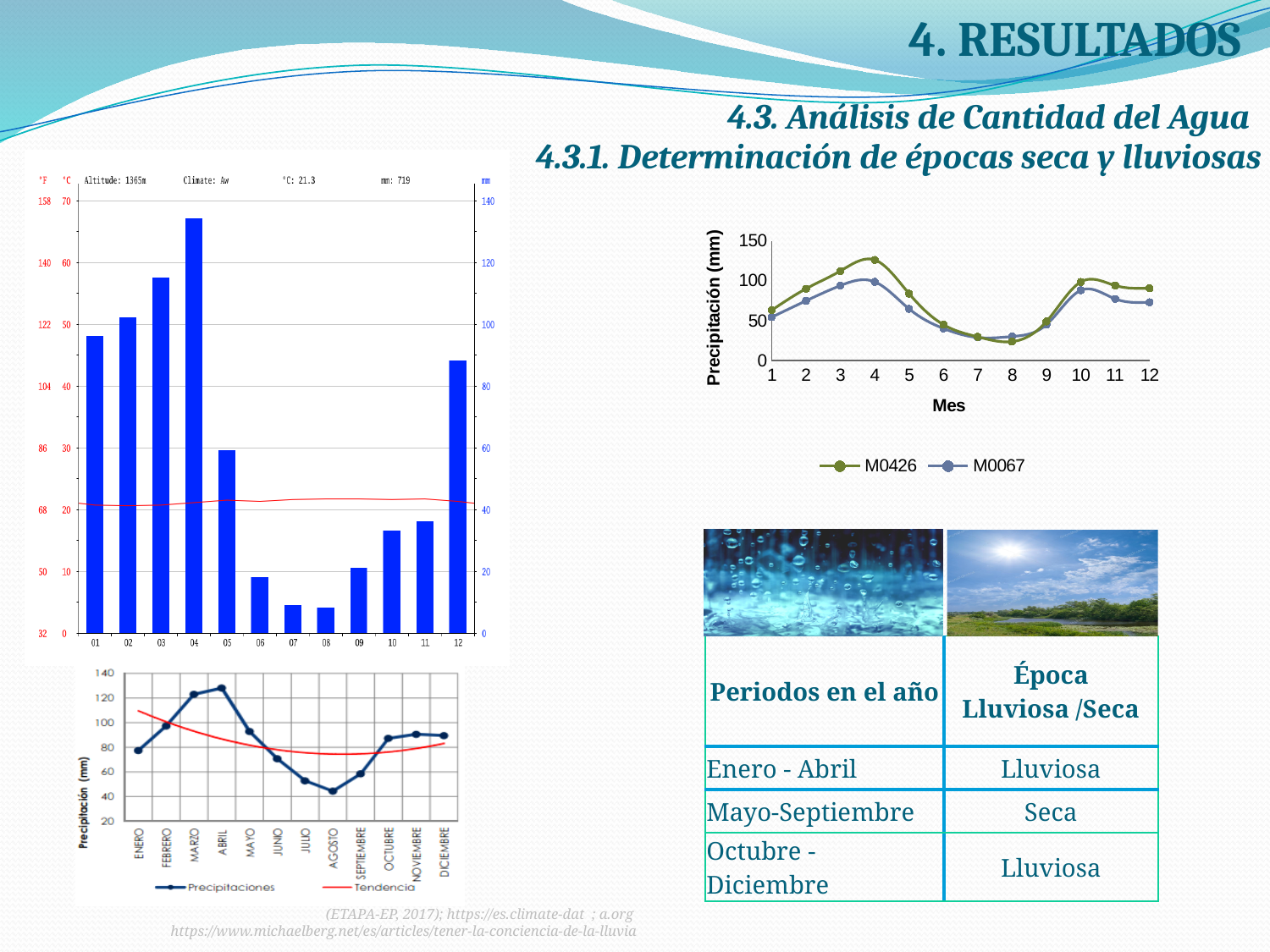
In the top-left bar chart, is the value for month 04 greater or less than 120 mm? greater In the top-left bar chart, how many months are plotted? 12 In the bottom-left line chart, which month has the lowest precipitation value? Agosto How many series does the legend of the bottom-left line chart list? 2 In the bottom-left line chart, which month has the highest precipitation value? Abril In the bottom-left line chart, is the precipitation for Agosto greater or less than 60? less What kind of chart is the top-left chart with the blue bars? bar chart In the top-left bar chart, which month has the highest bar? 04 In the right-hand line chart, which series has the larger value at month 4, M0426 or M0067? M0426 In the right-hand line chart, is the value for M0067 at month 8 greater or less than 50? less In the right-hand line chart, do the values for M0426 rise or fall from month 4 to month 8? fall